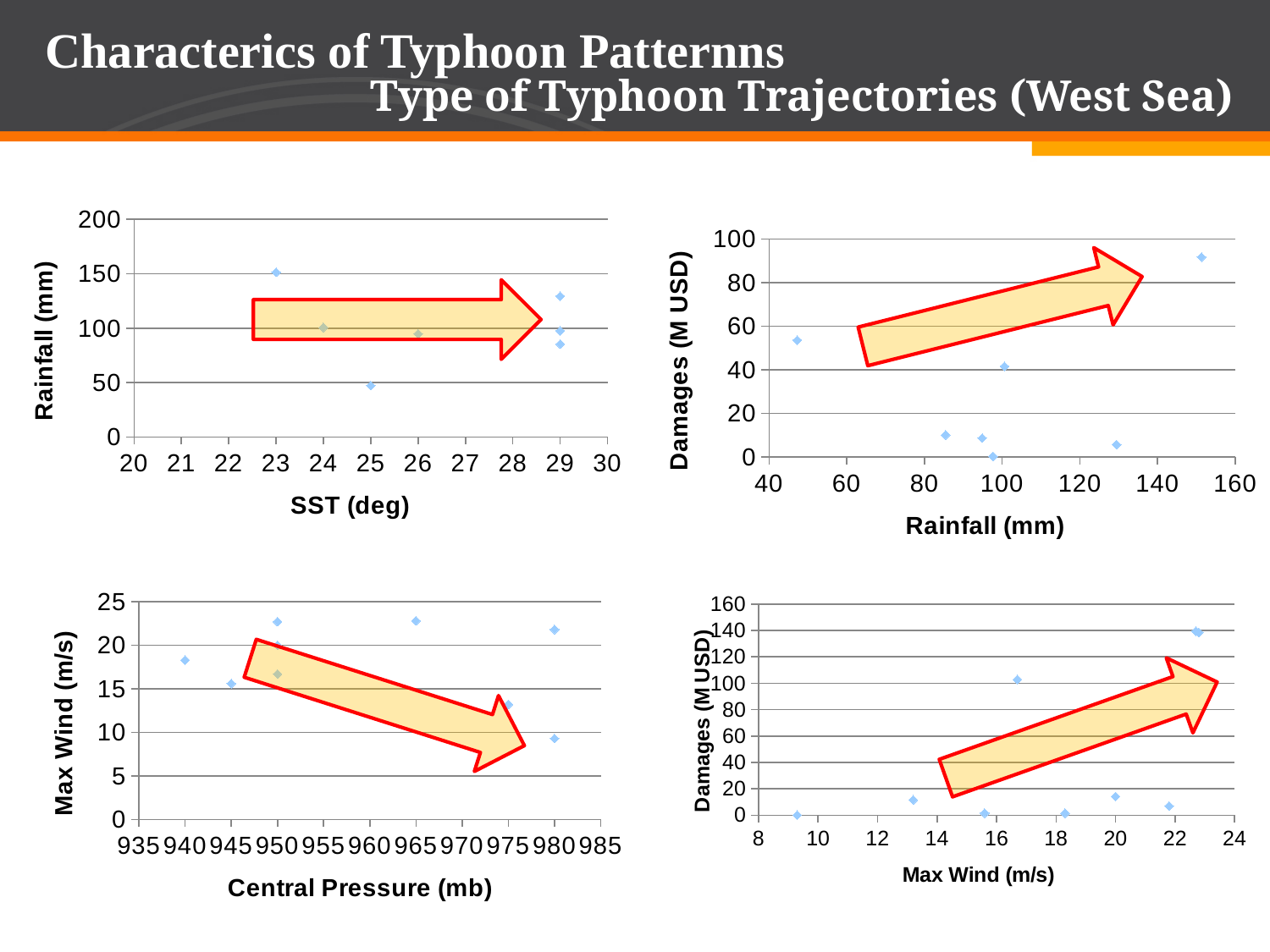
In the bottom-right chart, does the arrow indicate damages rising or falling as max wind increases? rising In the top-right chart, does the arrow indicate damages rising or falling as rainfall increases? rising In the bottom-left chart (Max Wind vs Central Pressure), does the arrow indicate max wind rising or falling as central pressure increases? falling In the top-right chart, is the damages value for the point near rainfall 130 greater or less than 20? less What is the x-axis label of the bottom-left chart? Central Pressure (mb) In the top-right chart (Damages vs Rainfall), is the damages value for the point near rainfall 150 greater or less than 80? greater In the bottom-right chart (Damages vs Max Wind), is the damages value for the point near max wind 23 greater or less than 120? greater What kind of chart is the top-left chart (Rainfall vs SST)? scatter chart What is the y-axis label of the top-right chart? Damages (M USD)